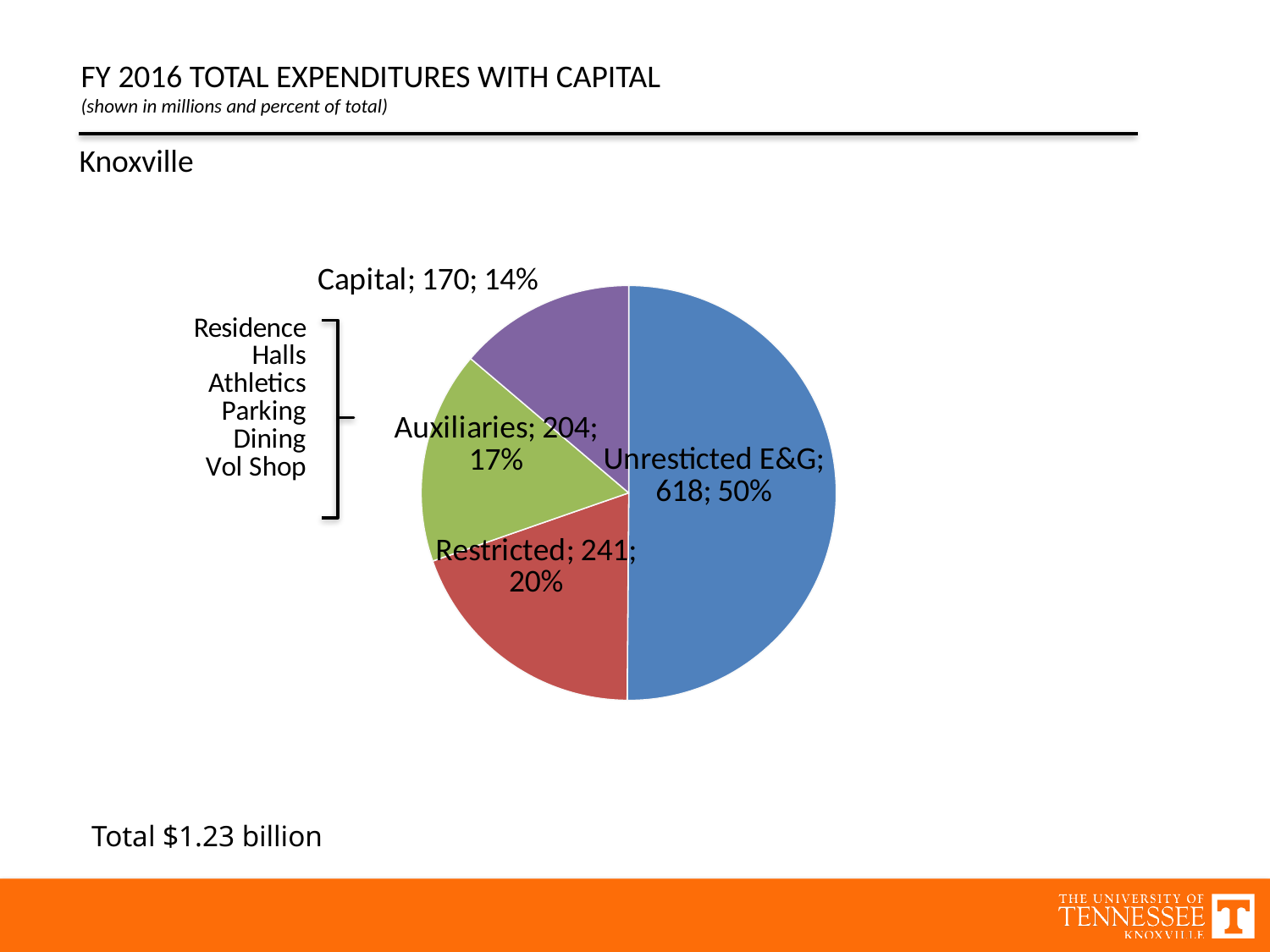
Which category has the largest slice? Unrestricted E&G Which category has the smallest slice? Capital What share of the total does Capital represent? 14% What is the value for Capital? 170 What kind of chart is shown on the slide? pie chart What is the difference between the values for Restricted and Auxiliaries? 37 Which is larger, the value for Auxiliaries or the value for Capital? Auxiliaries How many slices does the pie chart have? 4 What is the value for Restricted? 241 What is the value for Auxiliaries? 204 What is the value for Unrestricted E&G? 618 What share of the total does Restricted represent? 20%